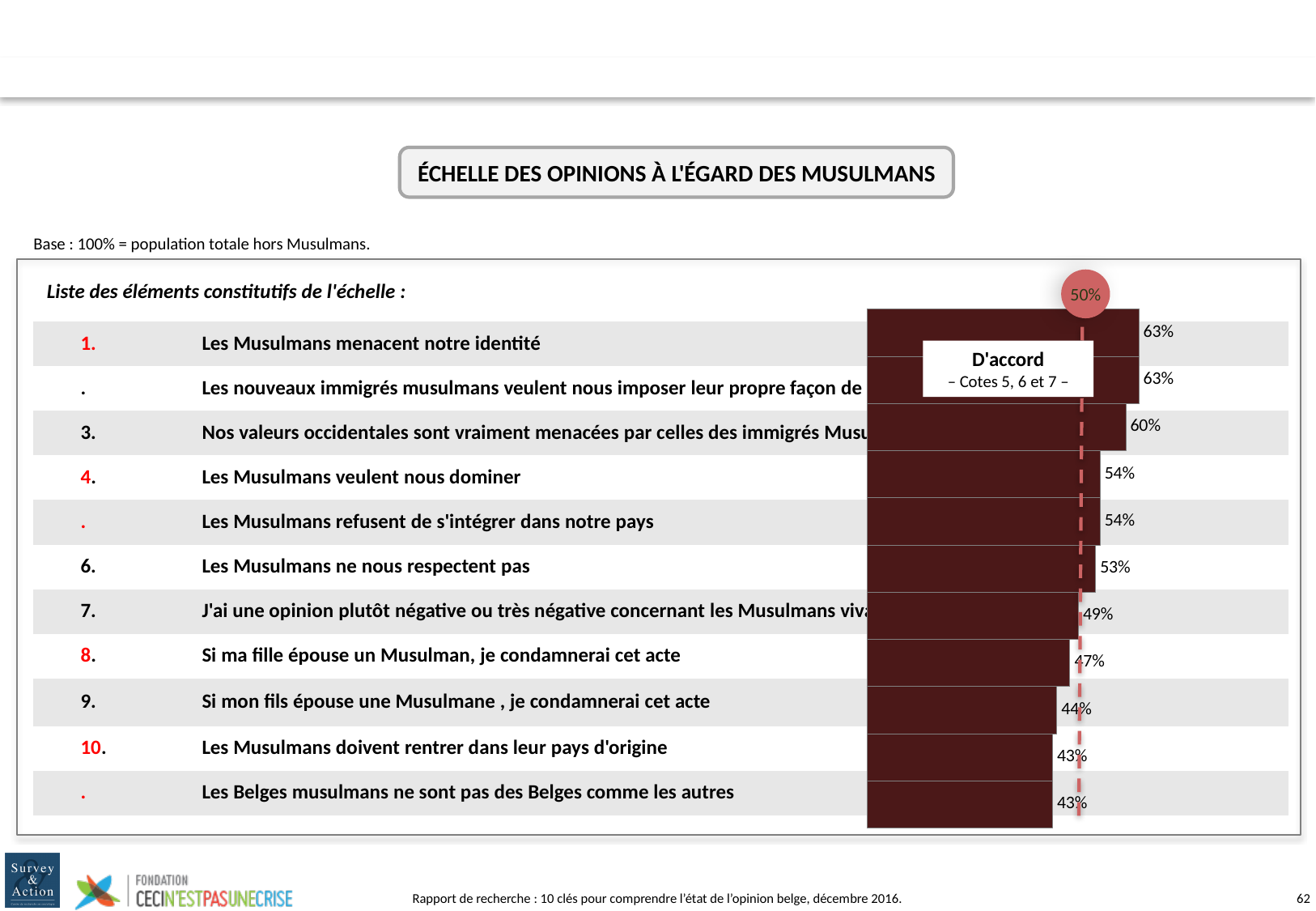
What is the difference in agreement between "Les Musulmans menacent notre identité" and "Les Musulmans doivent rentrer dans leur pays d'origine"? 20 percentage points What percentage agrees with the statement "Si ma fille épouse un Musulman, je condamnerai cet acte"? 47% What percentage agrees with the statement "Si mon fils épouse une Musulmane, je condamnerai cet acte"? 44% What percentage agrees with the statement "Les Musulmans veulent nous dominer"? 54% What percentage agrees with the statement "Les Musulmans doivent rentrer dans leur pays d'origine"? 43% Which statement has the lowest agreement percentage among the numbered items 1 to 10? Les Musulmans doivent rentrer dans leur pays d'origine Which has a higher agreement percentage: "Les Musulmans veulent nous dominer" or "Si ma fille épouse un Musulman, je condamnerai cet acte"? Les Musulmans veulent nous dominer What percentage agrees with the statement "Les Musulmans ne nous respectent pas"? 53% What value does the dashed vertical reference line in the chart mark? 50% How many statements are plotted in the chart? 11 What kind of chart is shown on the slide? Bar chart What percentage agrees with the statement "Les Musulmans menacent notre identité"? 63%